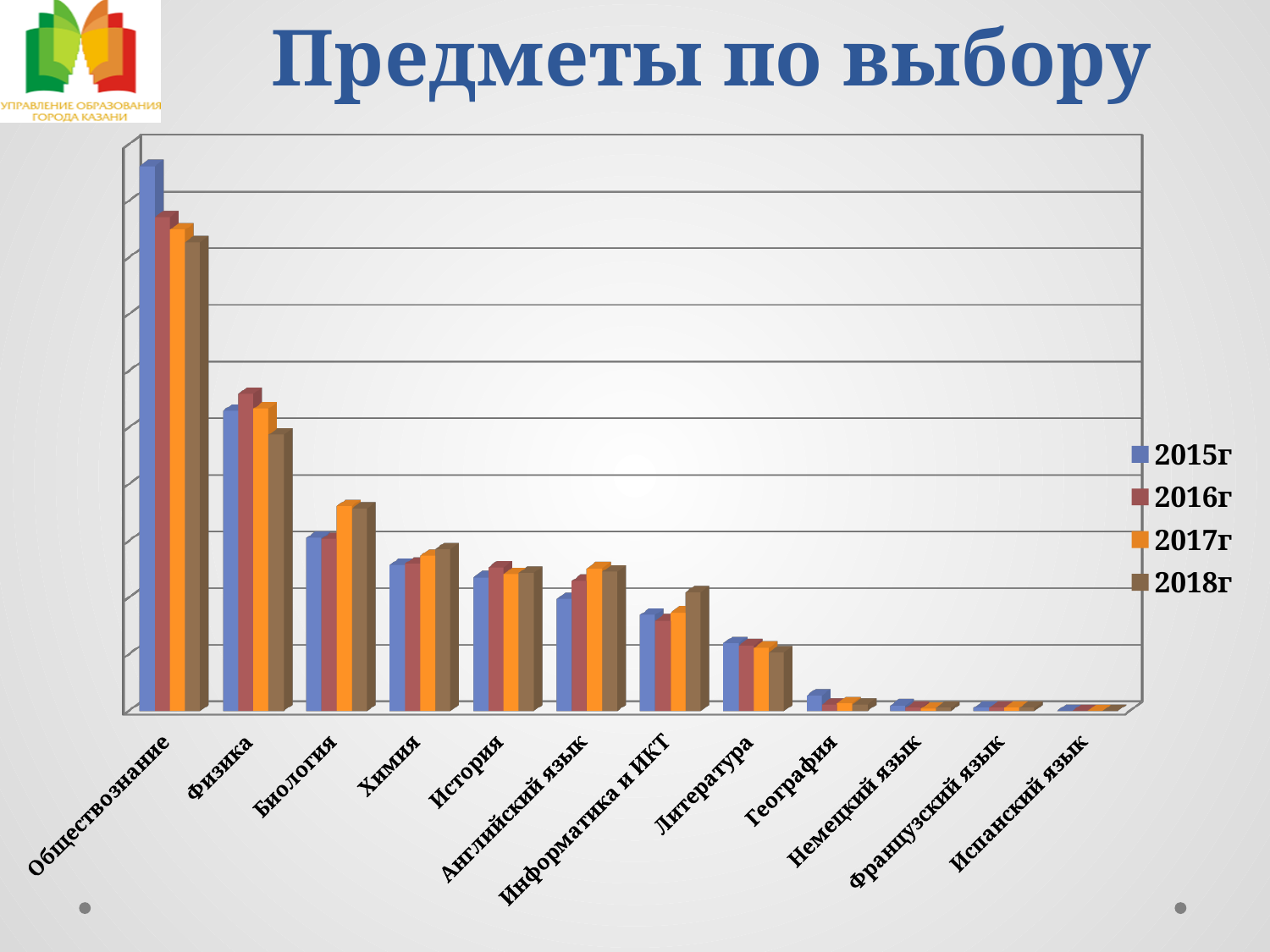
Which subject has the highest bars overall? Обществознание How many series does the legend list? 4 Which subject has higher values, Физика or Биология? Физика How many subjects (categories) are shown on the x axis? 12 Which subject has the lowest bars overall? Испанский язык For Физика, which year has the lowest bar? 2018г What type of chart is shown on the slide? bar chart What is the title of the slide with the chart? Предметы по выбору For Обществознание, which is larger, the 2015г value or the 2018г value? 2015г For Информатика и ИКТ, which year has the highest bar? 2018г Do the values for Обществознание rise or fall from 2015г to 2018г? fall Which years are listed in the legend? 2015г, 2016г, 2017г, 2018г